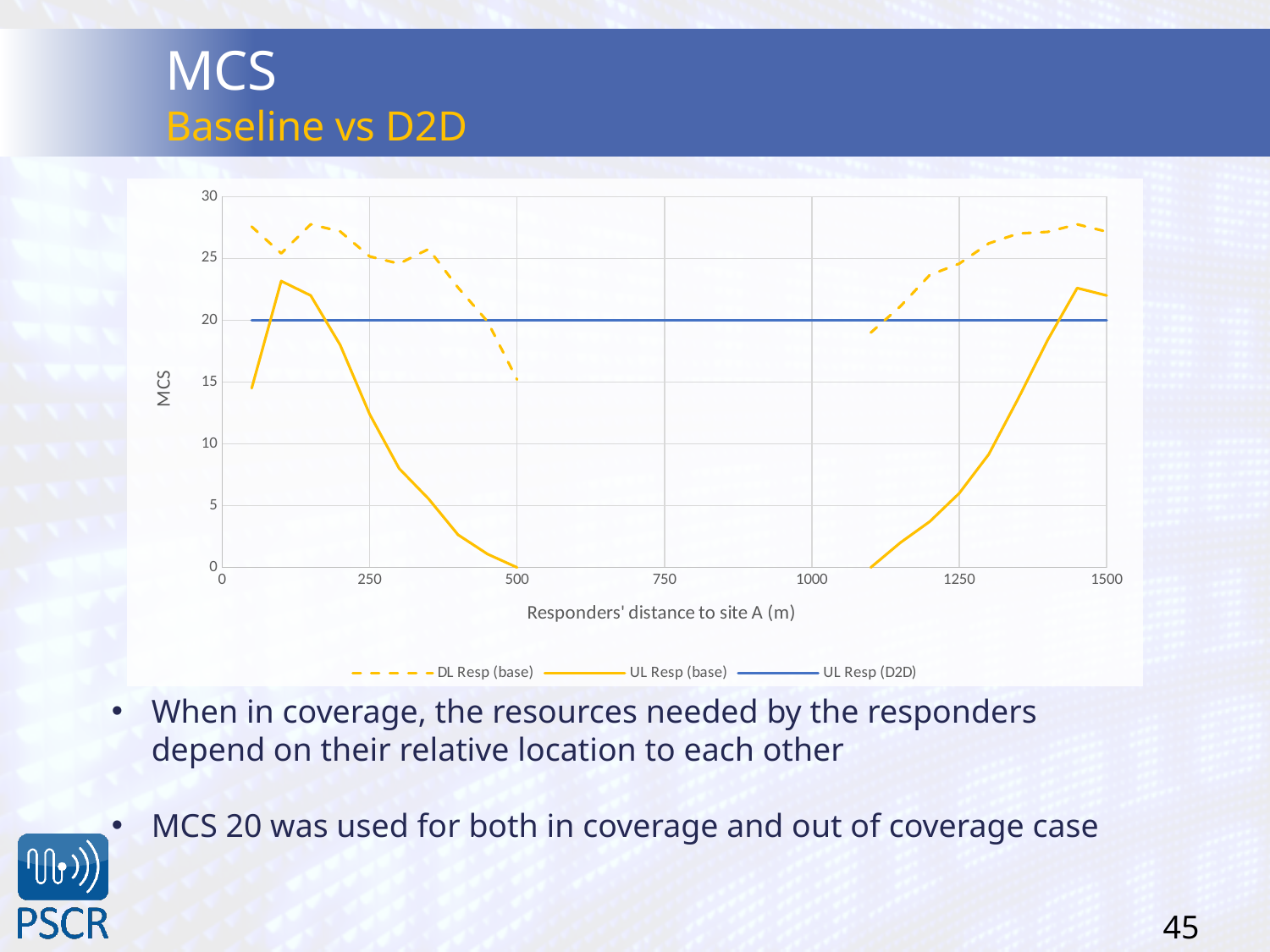
What MCS value does the UL Resp (D2D) series hold across all distances? 20 Is the UL Resp (base) value at a distance of 250 m greater or less than 15? less What is the title of the x axis? Responders' distance to site A (m) Is the UL Resp (base) value at a distance of 100 m greater or less than 20? greater How many series does the chart legend list? 3 Does the UL Resp (base) series rise or fall as distance increases from 250 m to 500 m? fall Is the DL Resp (base) value at a distance of 1250 m greater or less than 20? greater What kind of chart is shown on the slide? line chart Which series is drawn with a dashed line? DL Resp (base) At a distance of 250 m, which series has the higher MCS: DL Resp (base) or UL Resp (base)? DL Resp (base) At a distance of 1250 m, which series has the higher MCS: DL Resp (base) or UL Resp (D2D)? DL Resp (base)